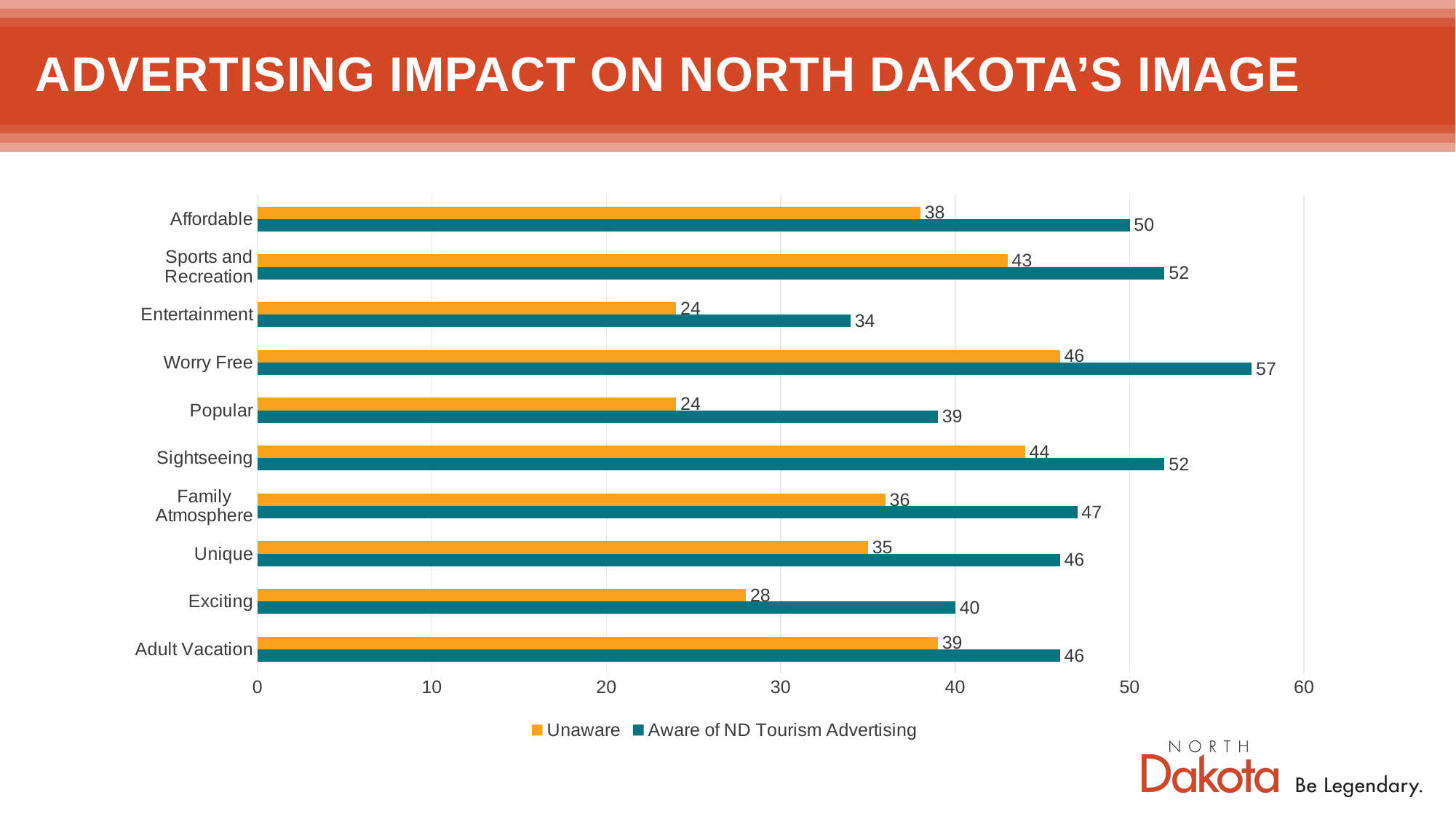
How many categories are shown on the chart? 10 Is the Aware of ND Tourism Advertising value for Sightseeing greater or less than 50? greater What is the title of the slide? ADVERTISING IMPACT ON NORTH DAKOTA'S IMAGE How many series does the legend list? 2 What is the Unaware value for Entertainment? 24 What is the difference between the Aware and Unaware values for Popular? 15 Which is larger for Exciting: the Unaware value or the Aware of ND Tourism Advertising value? Aware of ND Tourism Advertising What is the Unaware value for Affordable? 38 Which category has the highest Aware of ND Tourism Advertising value? Worry Free Which category has the lowest Aware of ND Tourism Advertising value? Entertainment What kind of chart is shown on the slide? Bar chart What is the Aware of ND Tourism Advertising value for Worry Free? 57